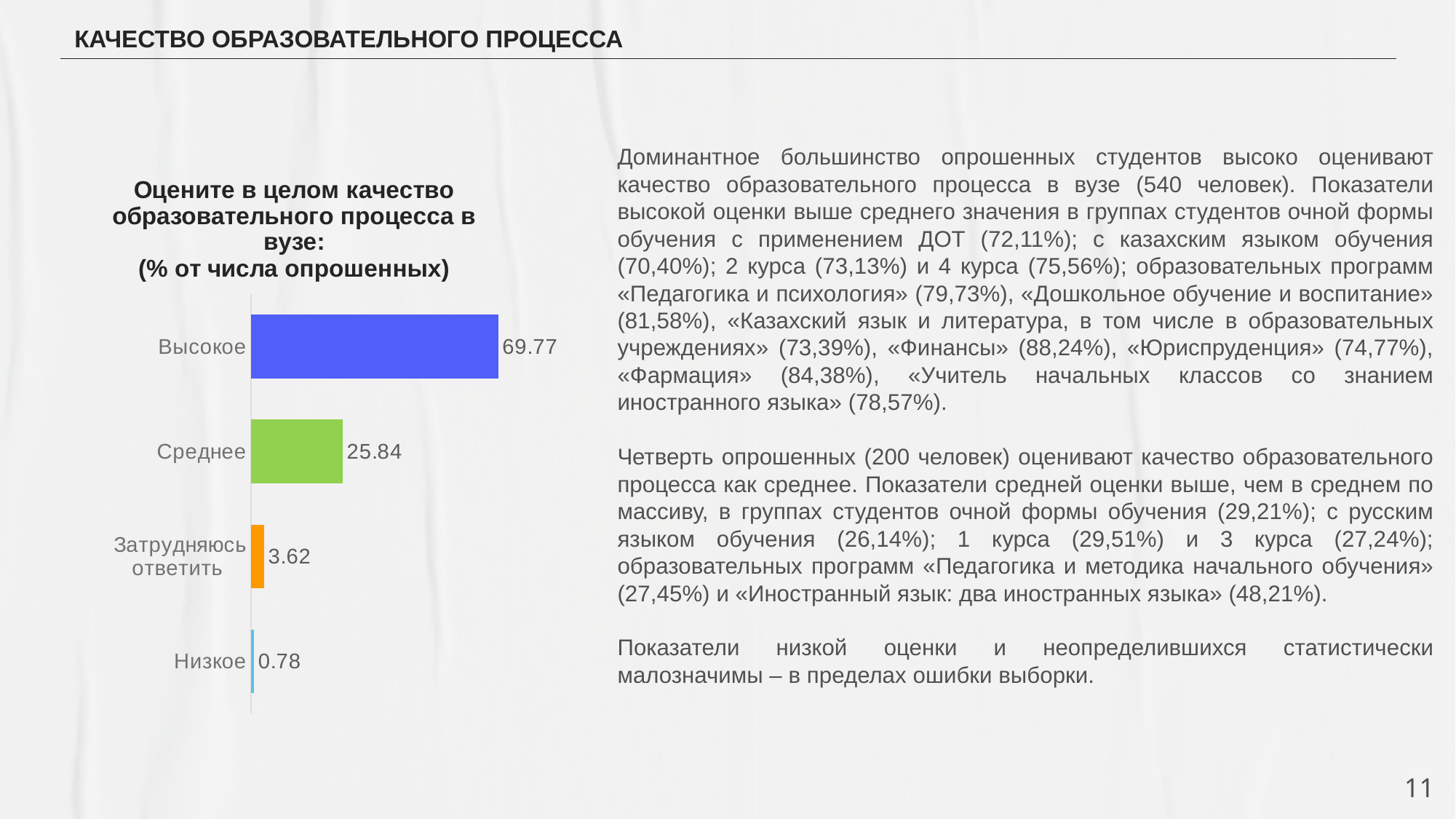
Which is larger, the value for "Среднее" or the value for "Затрудняюсь ответить"? Среднее What colour is the bar for "Среднее"? Green What is the value for "Низкое"? 0.78 Which category has the highest value? Высокое How many categories are shown in the chart? 4 What is the value for "Затрудняюсь ответить"? 3.62 What is the value for "Среднее"? 25.84 What kind of chart is shown on the slide? Bar chart Which category has the lowest value? Низкое What is the difference between the values for "Высокое" and "Среднее"? 43.93 What is the difference between the values for "Затрудняюсь ответить" and "Низкое"? 2.84 What is the value for "Высокое"? 69.77